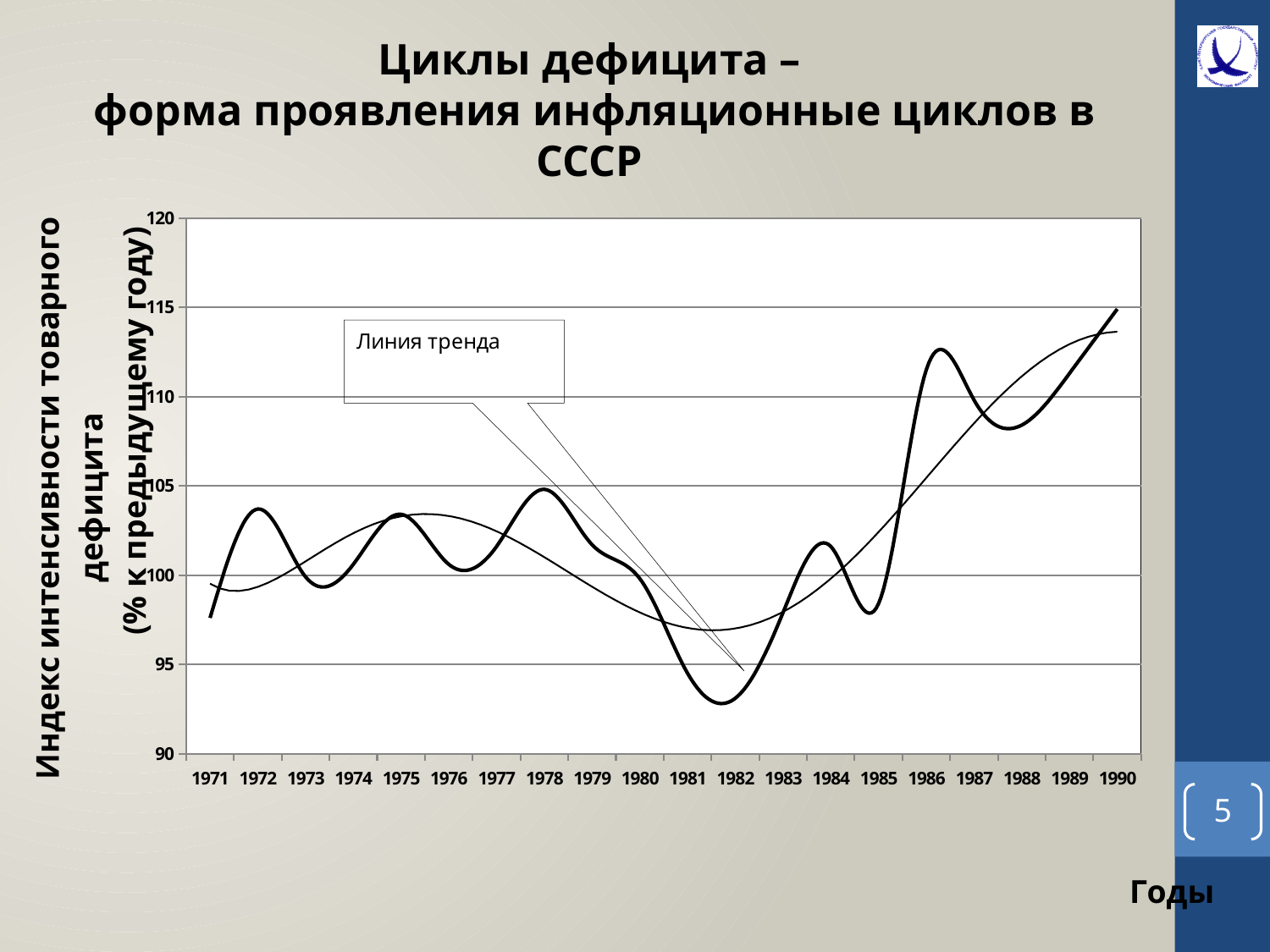
Is the value for 1986 greater or less than 110? greater Which year has the lowest value of the deficit intensity index? 1982 Does the index rise or fall between 1978 and 1982? fall How many years are marked on the x axis of the chart? 20 Is the value for 1971 greater or less than 100? less Is the value for 1988 greater or less than 105? greater Which year has the highest value of the deficit intensity index? 1990 What does the callout label on the chart say? Линия тренда What is the label of the x axis? Годы What kind of chart is shown on the slide? line chart Which year has the larger value, 1972 or 1973? 1972